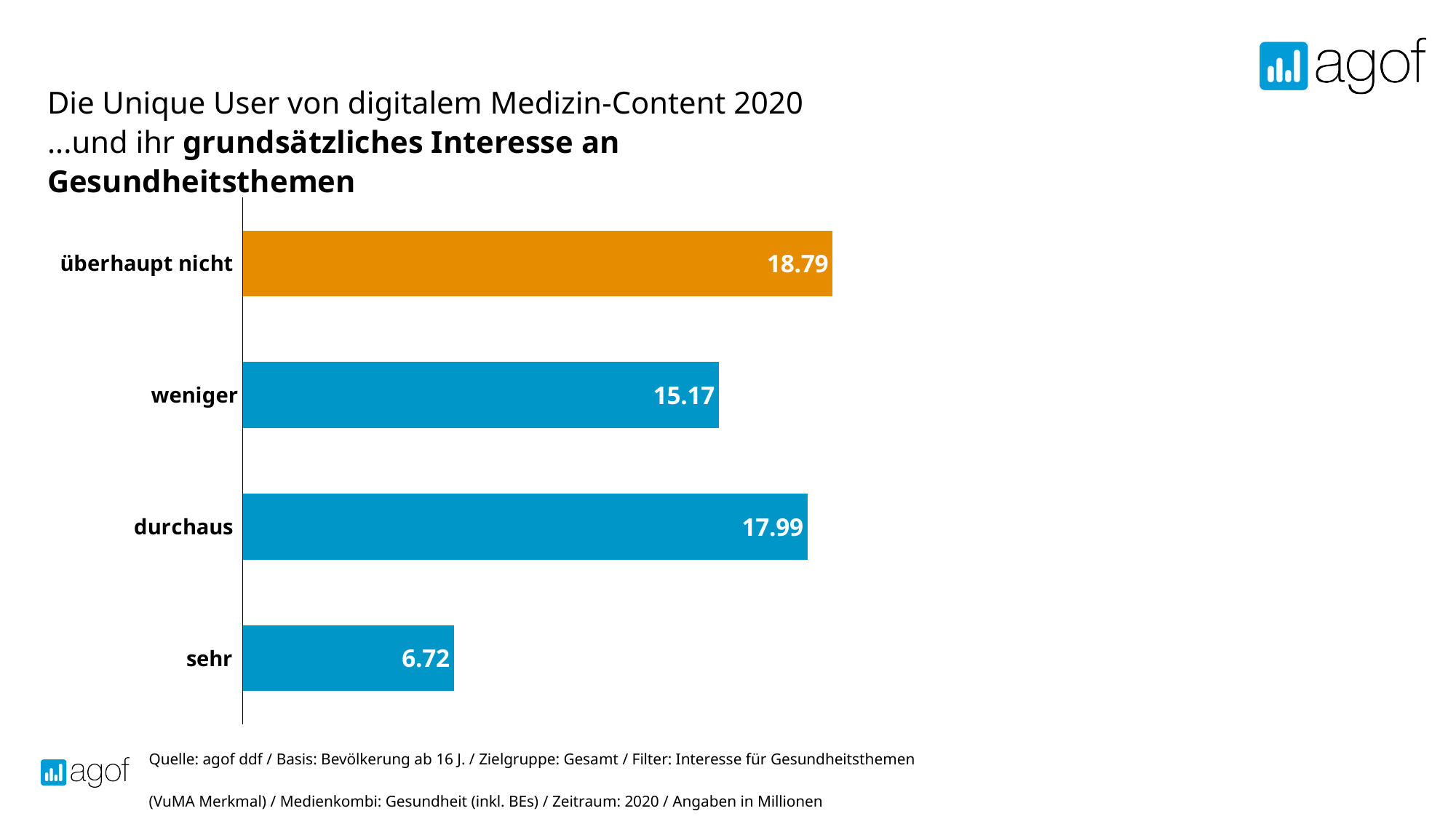
How many categories are shown in the chart? 4 Which bar is coloured orange rather than blue? überhaupt nicht What is the difference between the values for "durchaus" and "weniger"? 2.82 What is the value for "überhaupt nicht"? 18.79 What is the difference between the values for "überhaupt nicht" and "sehr"? 12.07 What is the value for "sehr"? 6.72 Which category has the highest value? überhaupt nicht What is the value for "weniger"? 15.17 What is the value for "durchaus"? 17.99 What kind of chart is shown on the slide? bar chart Which category has the lowest value? sehr Which is larger, the value for "durchaus" or the value for "weniger"? durchaus